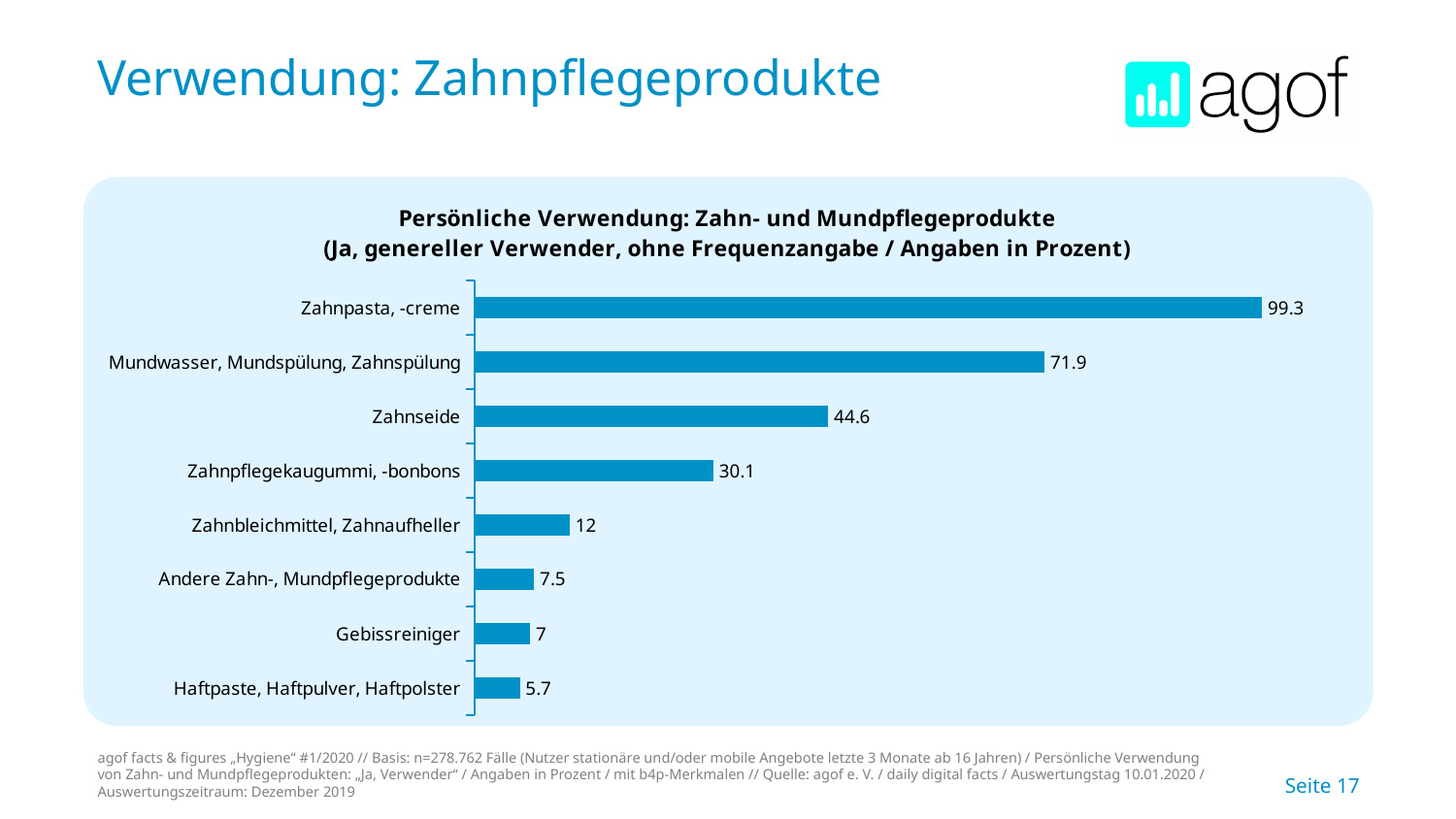
What kind of chart is shown on the slide? Bar chart What is the title of the chart? Persönliche Verwendung: Zahn- und Mundpflegeprodukte (Ja, genereller Verwender, ohne Frequenzangabe / Angaben in Prozent) How many categories are shown in the chart? 8 What is the difference between the values for Zahnseide and Zahnpflegekaugummi, -bonbons? 14.5 What is the difference between the values for Zahnpasta, -creme and Mundwasser, Mundspülung, Zahnspülung? 27.4 Which category has the lowest value? Haftpaste, Haftpulver, Haftpolster Which category has the highest value? Zahnpasta, -creme What is the value for Mundwasser, Mundspülung, Zahnspülung? 71.9 What is the value for Zahnseide? 44.6 What is the value for Gebissreiniger? 7 What is the value for Zahnpasta, -creme? 99.3 Which is larger, the value for Zahnbleichmittel, Zahnaufheller or the value for Andere Zahn-, Mundpflegeprodukte? Zahnbleichmittel, Zahnaufheller